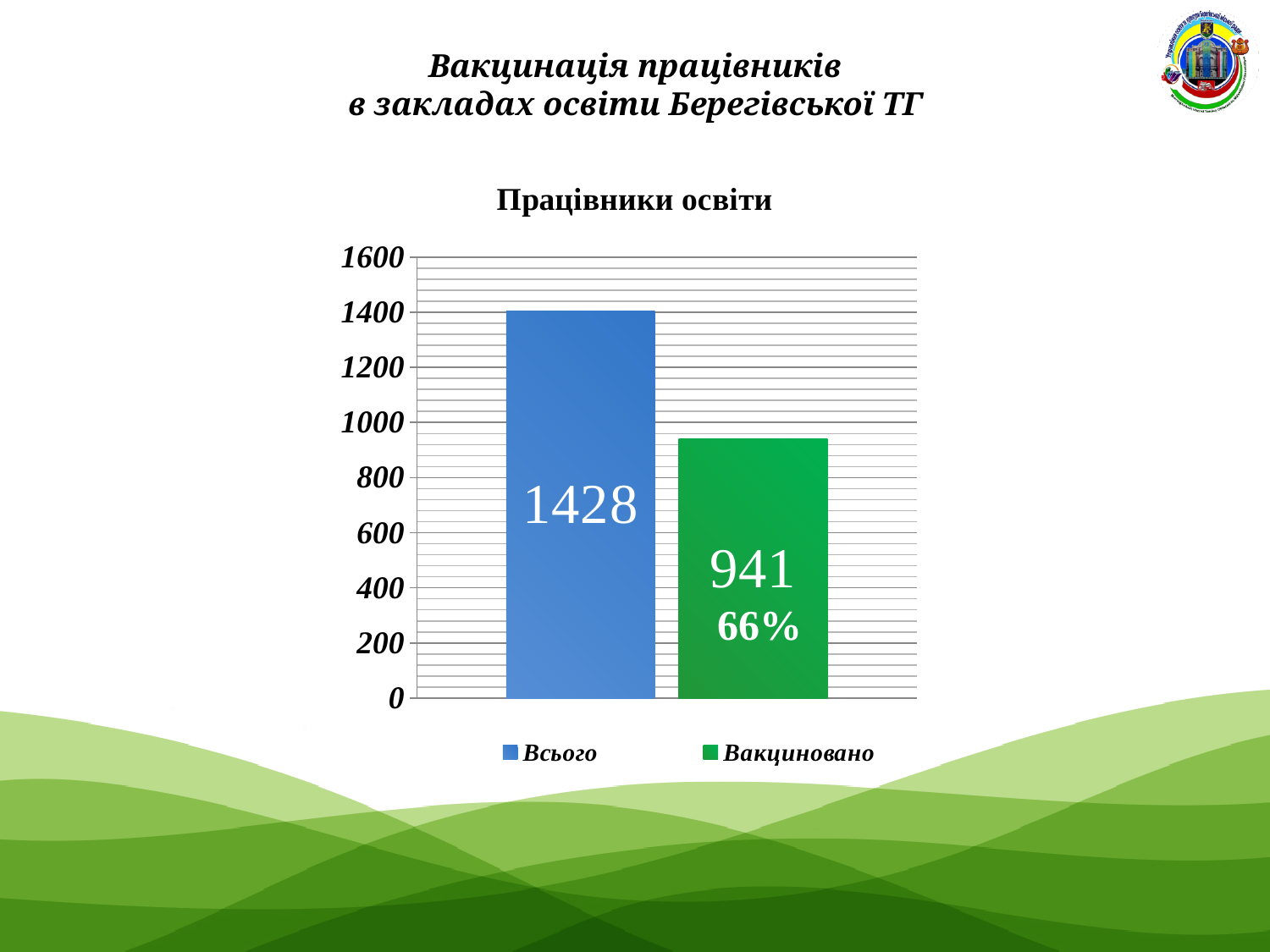
Is the value for Всього greater or less than 1400? greater What is the value for Вакциновано? 941 Which bar is the highest? Всього Is the value for Вакциновано greater or less than 1000? less Which series has the higher value, Всього or Вакциновано? Всього Which bar is the lowest? Вакциновано What is the title of the chart? Працівники освіти What percentage is printed on the Вакциновано bar? 66% What is the value for Всього? 1428 What is the difference between the Всього and Вакциновано values? 487 How many series does the legend list? 2 What kind of chart is shown on the slide? bar chart